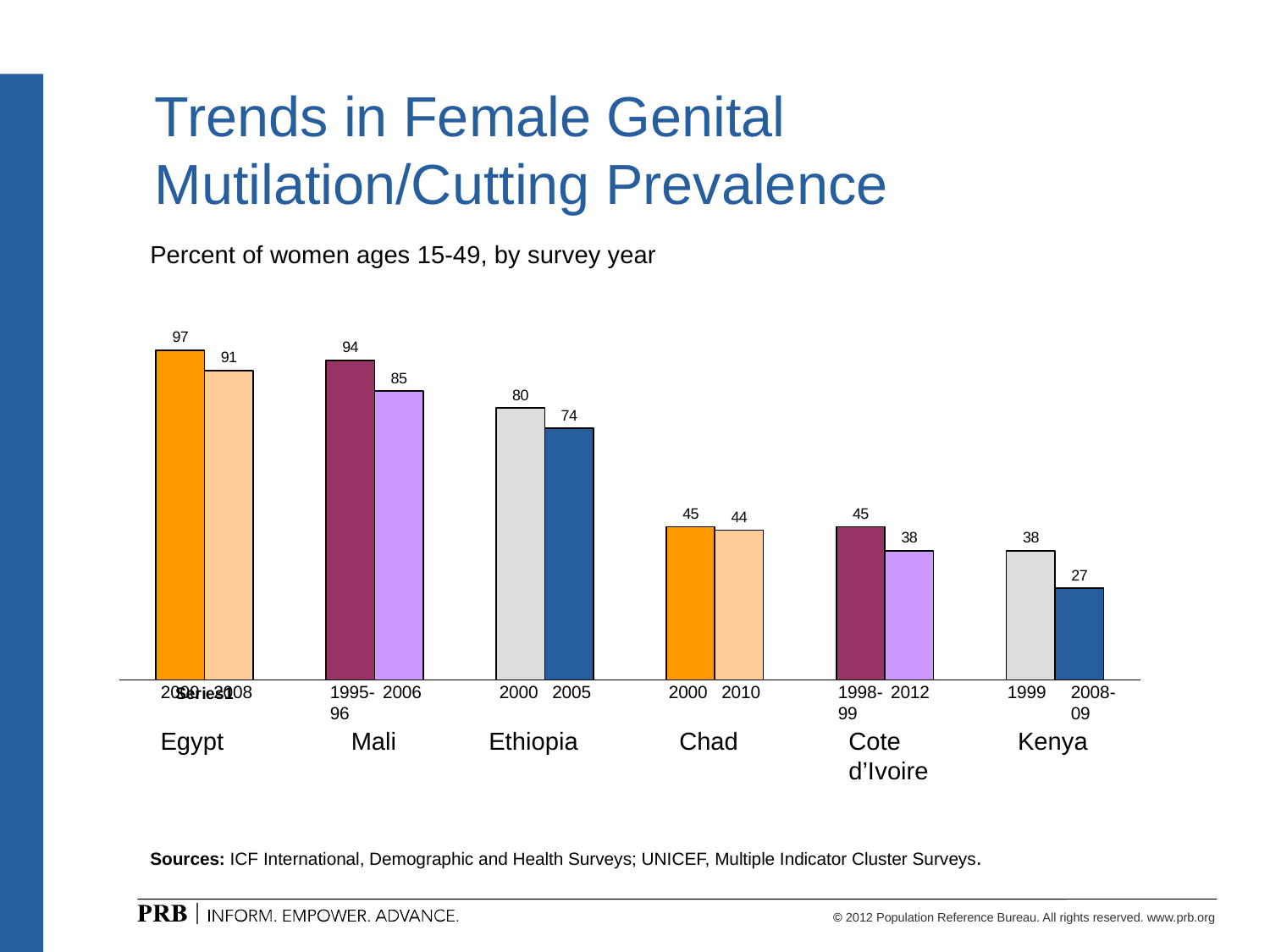
What is the value for Cote d'Ivoire in 2012? 38 How many countries are shown on the chart? 6 Which country has the highest bar on the chart? Egypt Which is larger, Ethiopia's 2005 value or Chad's 2000 value? Ethiopia's 2005 value By how many percentage points did Kenya's value fall from 1999 to 2008-09? 11 Which bar on the chart has the lowest value? Kenya 2008-09 What is the FGM/C prevalence for Egypt in 2008? 91 What is the value for Mali in 1995-96? 94 What is the value for Kenya in 2008-09? 27 What is the difference between Mali's 1995-96 and 2006 values? 9 What type of chart is shown on the slide? Bar chart What is the title of the chart on the slide? Trends in Female Genital Mutilation/Cutting Prevalence